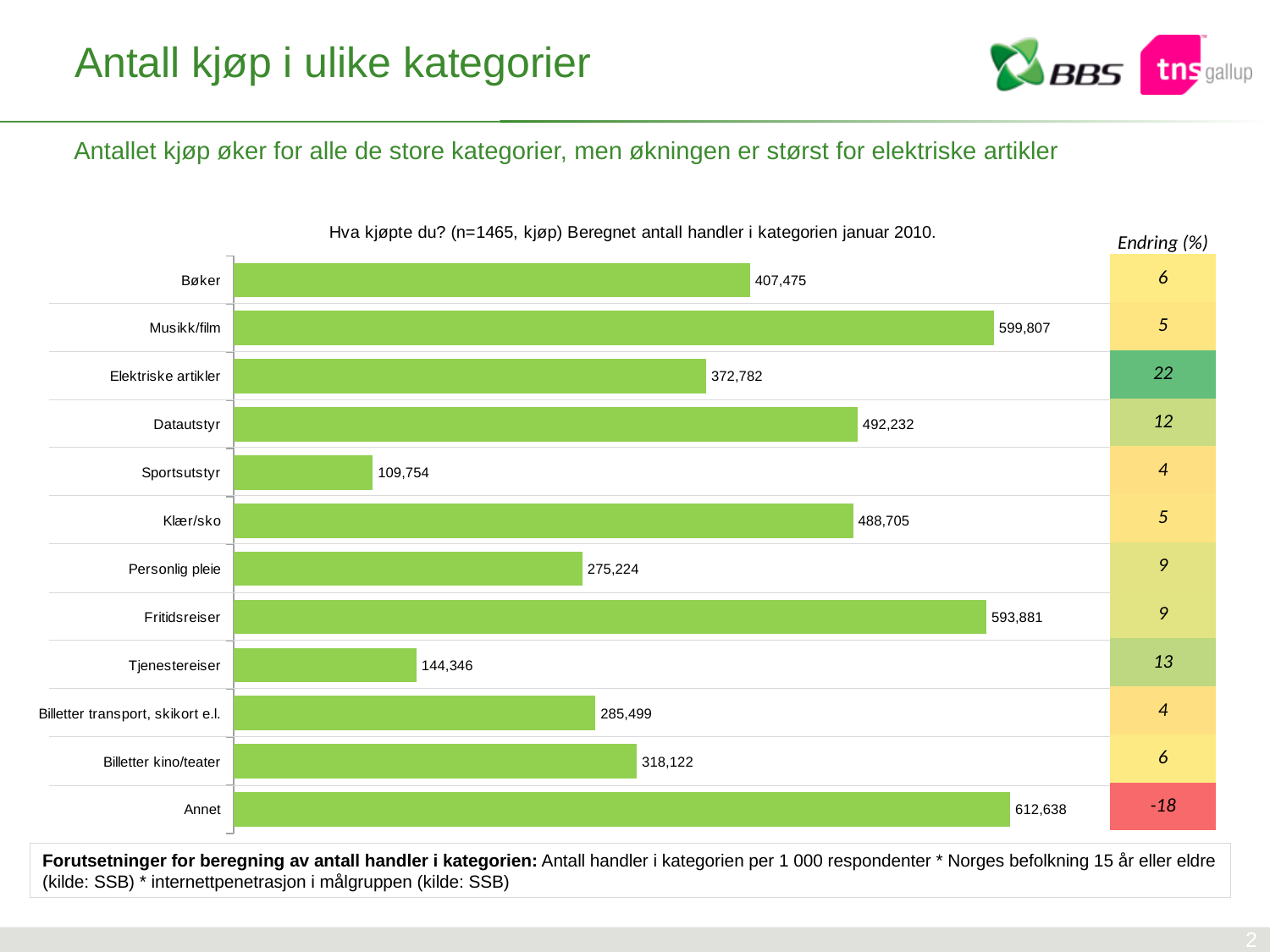
Which is larger, the value for Datautstyr or the value for Personlig pleie? Datautstyr Which category has the highest value? Annet Which category has the lowest value? Sportsutstyr What is the value for Billetter kino/teater? 318,122 What is the value for Bøker? 407,475 How many categories are shown in the chart? 12 What is the title of the chart? Hva kjøpte du? (n=1465, kjøp) Beregnet antall handler i kategorien januar 2010. What is the value for Fritidsreiser? 593,881 What is the value for Sportsutstyr? 109,754 What is the difference between the values for Bøker and Elektriske artikler? 34,693 What kind of chart is shown on the slide? Bar chart What is the difference between the values for Billetter kino/teater and Billetter transport, skikort e.l.? 32,623